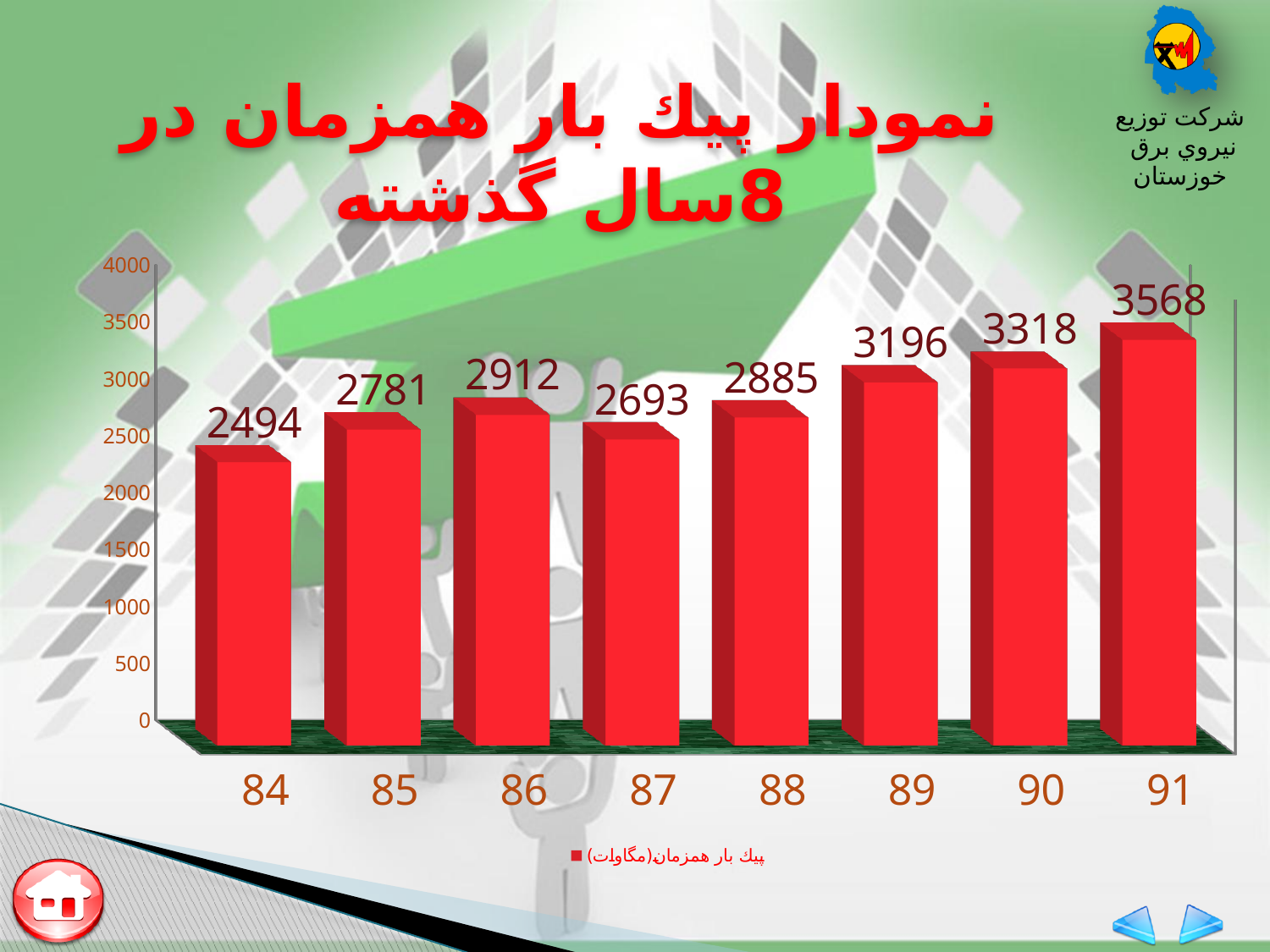
Which is larger, the value for year 86 or the value for year 88? 86 Is the value for year 89 greater or less than 3000? greater What is the difference between the values for year 86 and year 87? 219 How many series does the legend list? 1 Which year has the highest value? 91 Which year has the lowest value? 84 What is the difference between the values for year 91 and year 84? 1074 What is the value for year 91? 3568 What is the value for year 88? 2885 What is the value for year 84? 2494 How many years are shown on the x axis? 8 What kind of chart is shown on the slide? bar chart